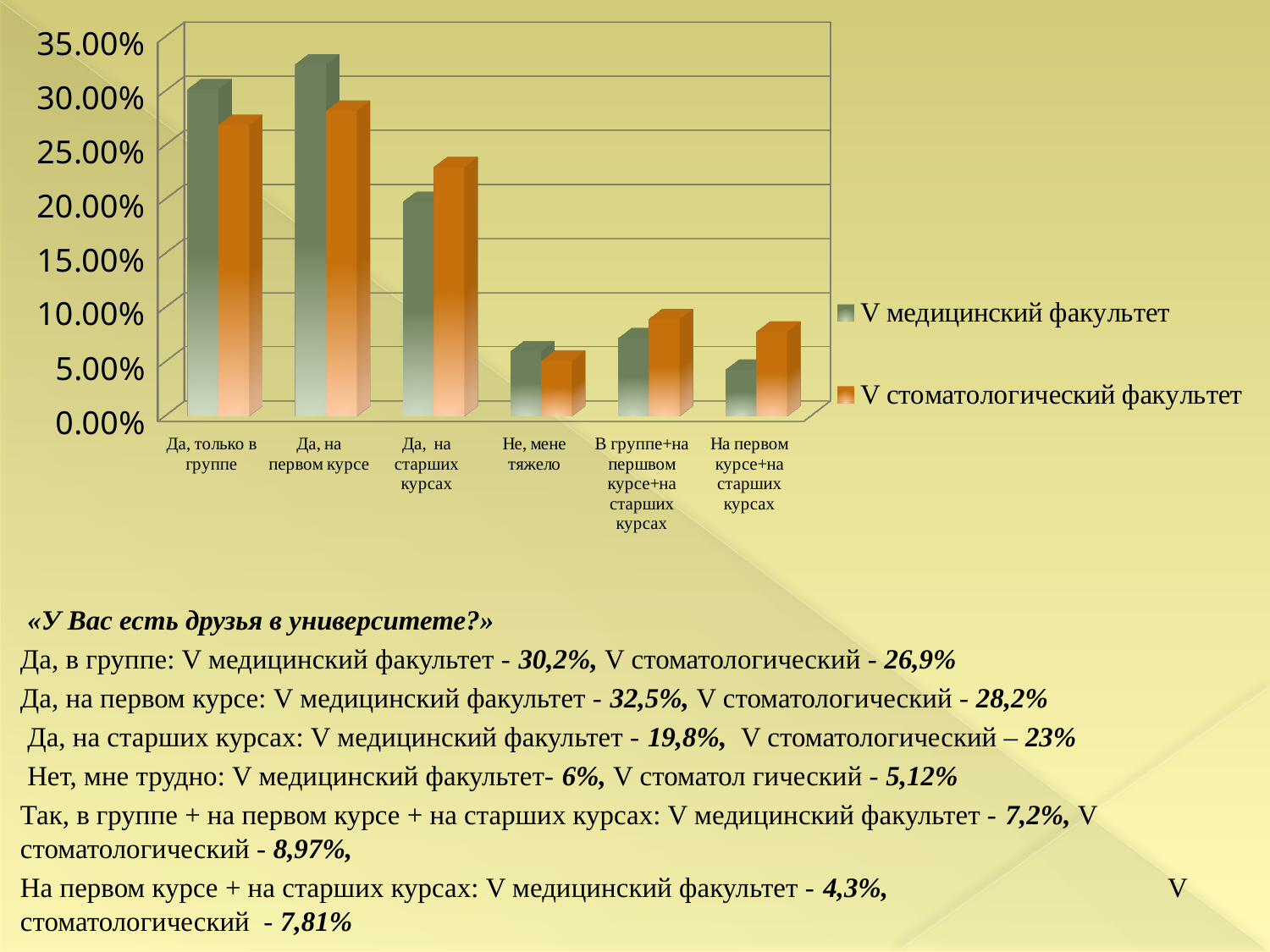
What kind of chart is shown on the slide? bar chart How many categories are shown along the x axis of the chart? 6 Which category has the lowest value for V медицинский факультет? На первом курсе+на старших курсах Which category has the lowest value for V стоматологический факультет? Не, мене тяжело In the category "Да, на старших курсах", which series has the larger value? V стоматологический факультет Is the value for V медицинский факультет in the category "Да, только в группе" greater or less than 25.00%? greater What is the value for V медицинский факультет in the category "Да, на первом курсе"? 32,5% How many series does the chart legend list? 2 What is the value for V стоматологический факультет in the category "Да, только в группе"? 26,9% Which category has the highest value for V медицинский факультет? Да, на первом курсе What is the value for V стоматологический факультет in the category "Не, мене тяжело"? 5,12% What is the difference between V медицинский факультет and V стоматологический факультет in the category "Да, на первом курсе"? 4,3%